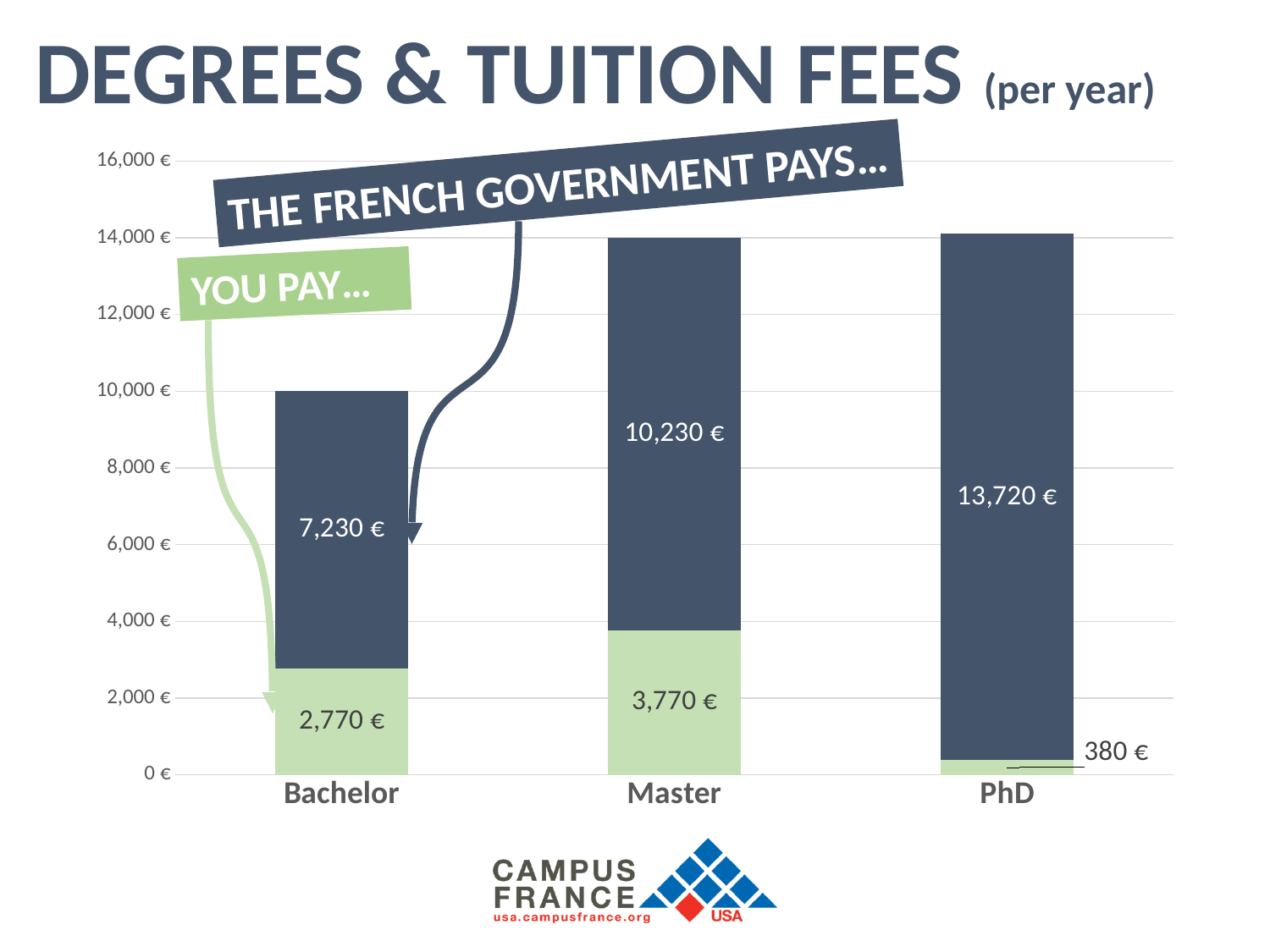
Is the amount the student pays for a Master larger than the amount the student pays for a Bachelor? Yes How much does the student pay per year for a Bachelor degree? 2,770 € What is the total tuition fee per year for a Bachelor degree (student plus government)? 10,000 € How much does the French government pay per year for a PhD? 13,720 € What kind of chart is shown on the slide? Stacked bar chart How much does the French government pay per year for a Master degree? 10,230 € Which degree has the lowest amount paid by the student? PhD How much does the student pay per year for a PhD? 380 € Which degree has the highest amount paid by the French government? PhD What is the total tuition fee per year for a PhD (student plus government)? 14,100 € How many degree categories are shown on the x axis? 3 What is the difference between what the student pays for a Master and for a Bachelor? 1,000 €